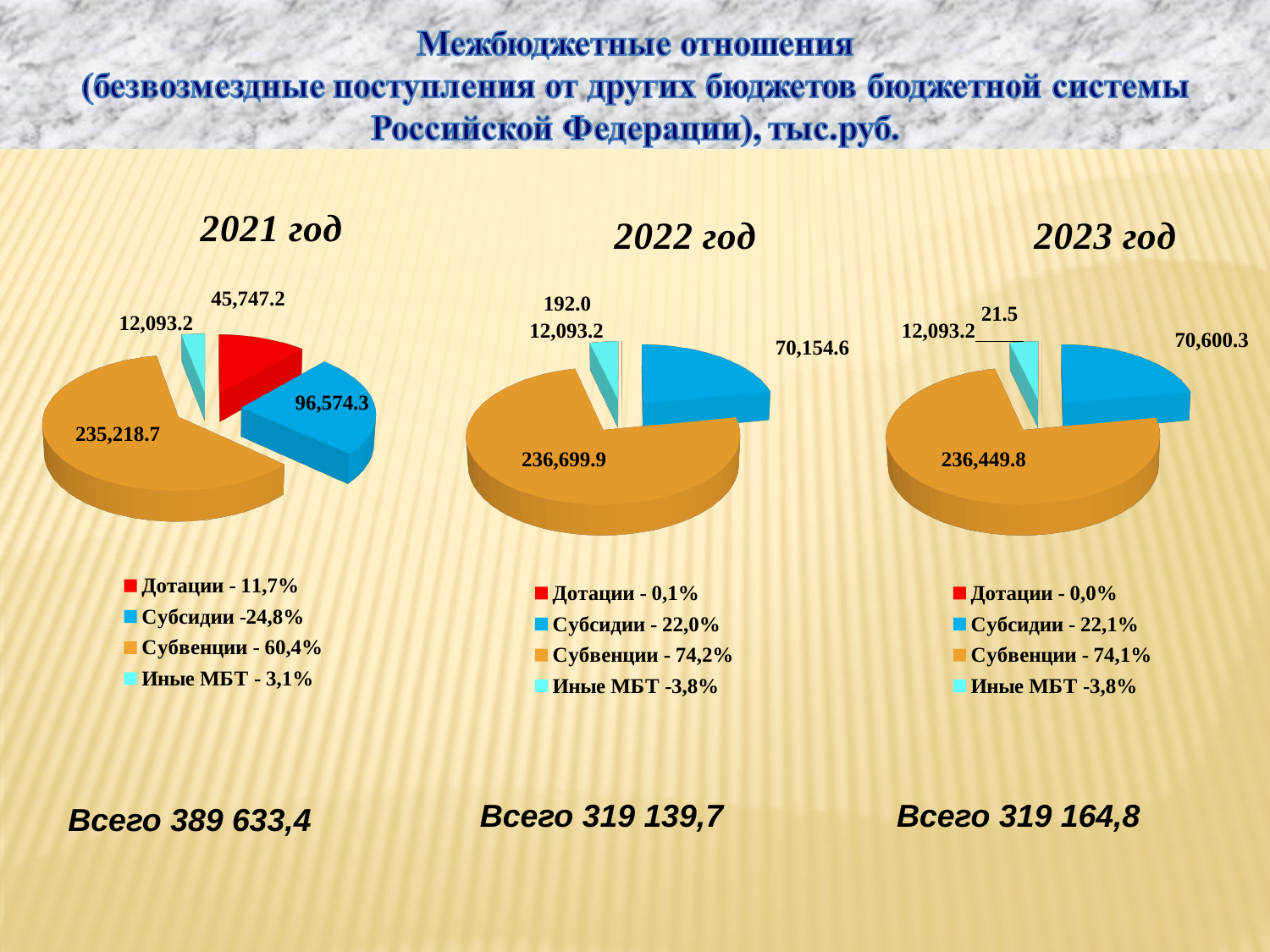
In the 2021 год pie chart, what is the difference between the values for Субвенции and Субсидии? 138,644.4 In the 2021 год pie chart, which category has the largest slice? Субвенции What kind of chart is used for 2022 год? Pie chart In the 2022 год pie chart, what is the difference between the values for Субсидии and Иные МБТ? 58,061.4 In the 2021 год pie chart, what is the value for Субвенции? 235,218.7 According to the legend of the 2022 год chart, what share of the pie is Субвенции? 74,2% In the 2022 год pie chart, which category has the smallest slice? Дотации In the 2021 год pie chart, which is larger: Дотации or Субсидии? Субсидии In the 2021 год pie chart, what colour is the Дотации slice? Red In the 2023 год pie chart, what is the value for Дотации? 21.5 In the 2022 год pie chart, what is the value for Субсидии? 70,154.6 How many categories does the legend of the 2023 год pie chart list? 4